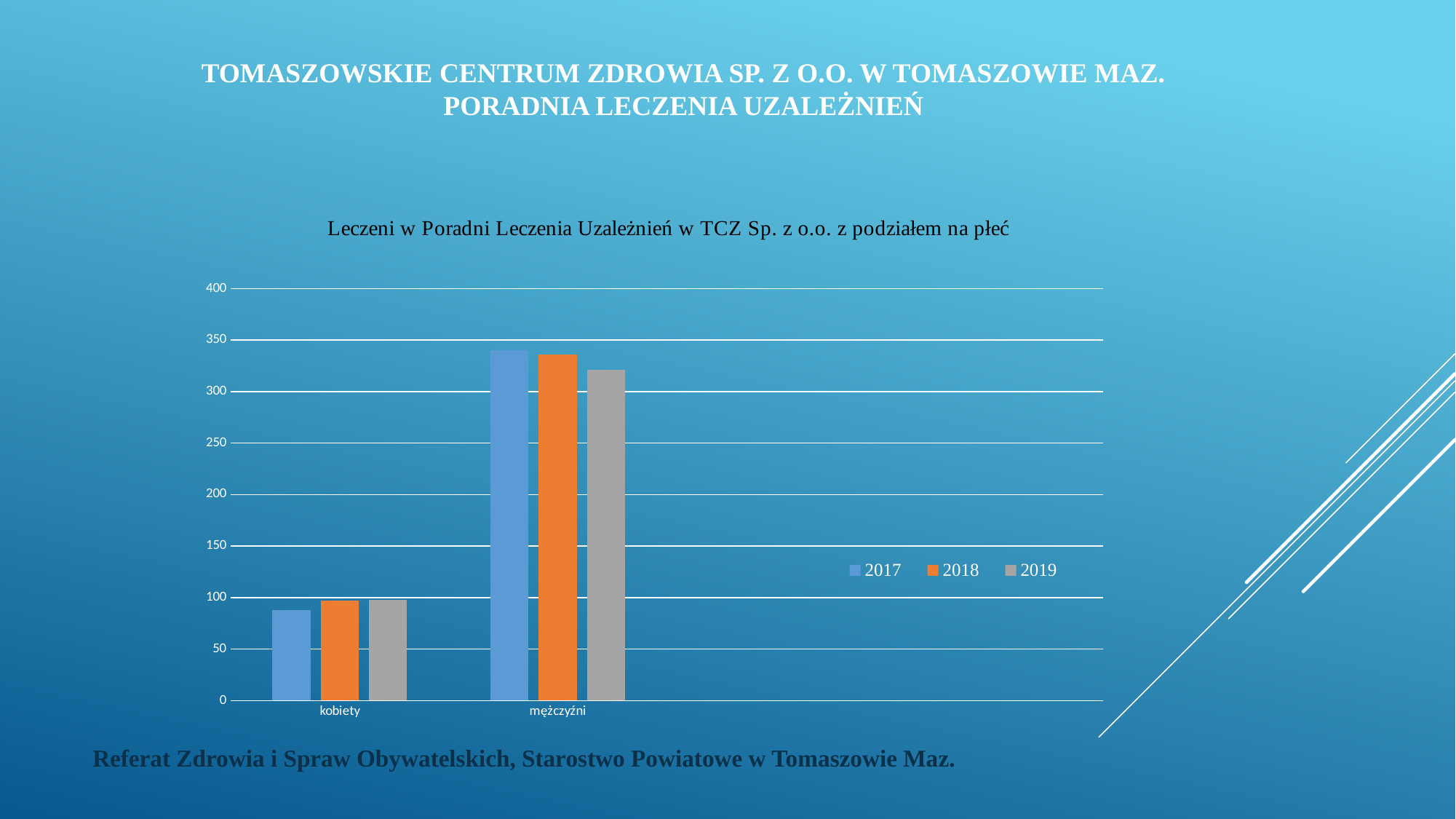
Is the value for mężczyźni in 2019 greater or less than 350? less Is the value for mężczyźni in 2017 greater or less than 300? greater What is the title of the chart? Leczeni w Poradni Leczenia Uzależnień w TCZ Sp. z o.o. z podziałem na płeć For mężczyźni, do the values rise or fall from 2017 to 2019? fall How many categories are shown on the x axis? 2 Is the value for kobiety in 2017 greater or less than 100? less Which category has the lowest value for 2019? kobiety What kind of chart is shown on the slide? bar chart Which category has the highest value for 2017? mężczyźni For mężczyźni, which is larger: the value for 2017 or the value for 2019? 2017 How many series does the legend list? 3